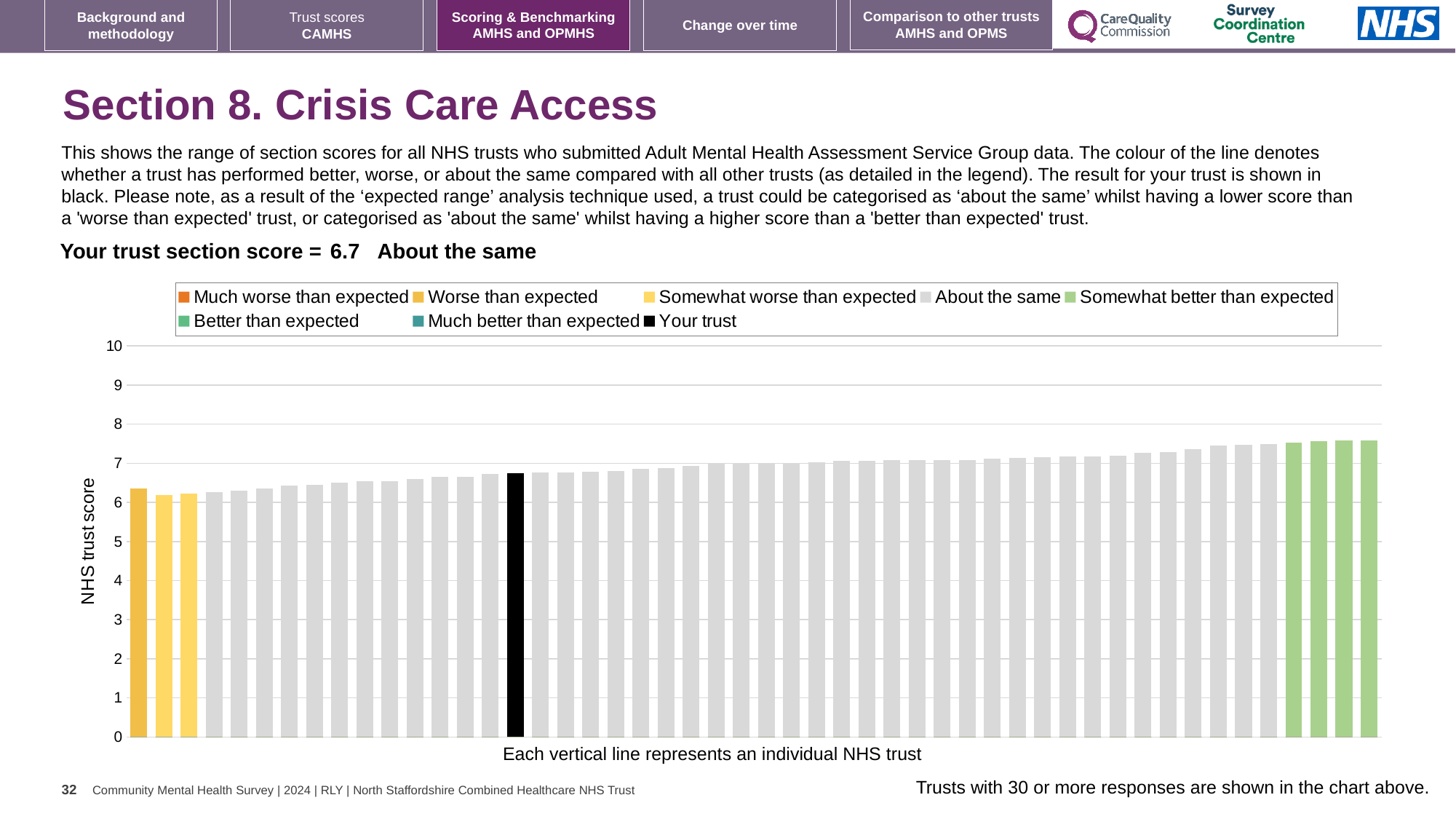
Is the value for the tallest bar greater or less than 8? less What colour is the bar representing your trust? black Is the value for your trust greater or less than 7? less What kind of chart is shown on the slide? bar chart Which legend category do the tallest bars on the right belong to? Somewhat better than expected Is the value for your trust greater or less than 6? greater What is the section score for your trust? 6.7 Which is larger, the leftmost bar or the rightmost bar? the rightmost bar Do the bar values rise or fall from left to right along the x axis? rise Which category is your trust placed in for this section? About the same How many entries does the chart legend list? 8